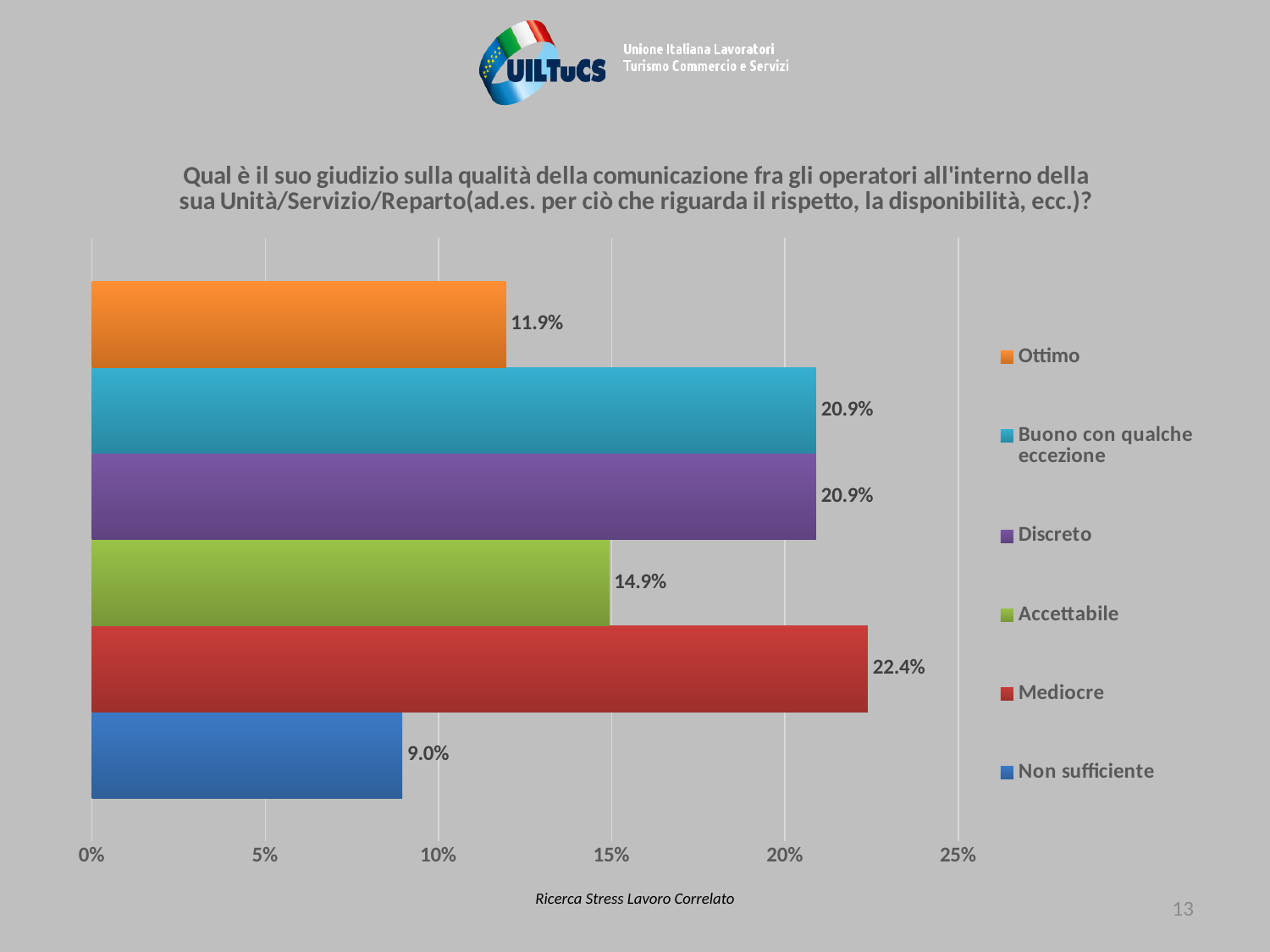
Which is larger, the value for Accettabile or the value for Ottimo? Accettabile How many series does the legend list? 6 What is the value for Accettabile? 14.9% What is the value for Ottimo? 11.9% What is the value for Discreto? 20.9% What is the difference between the values for Mediocre and Non sufficiente? 13.4% What is the value for Non sufficiente? 9.0% Which category has the lowest value? Non sufficiente What colour is the bar for Buono con qualche eccezione? Light blue Which category has the highest value? Mediocre What is the value for Mediocre? 22.4% What kind of chart is shown on the slide? Bar chart